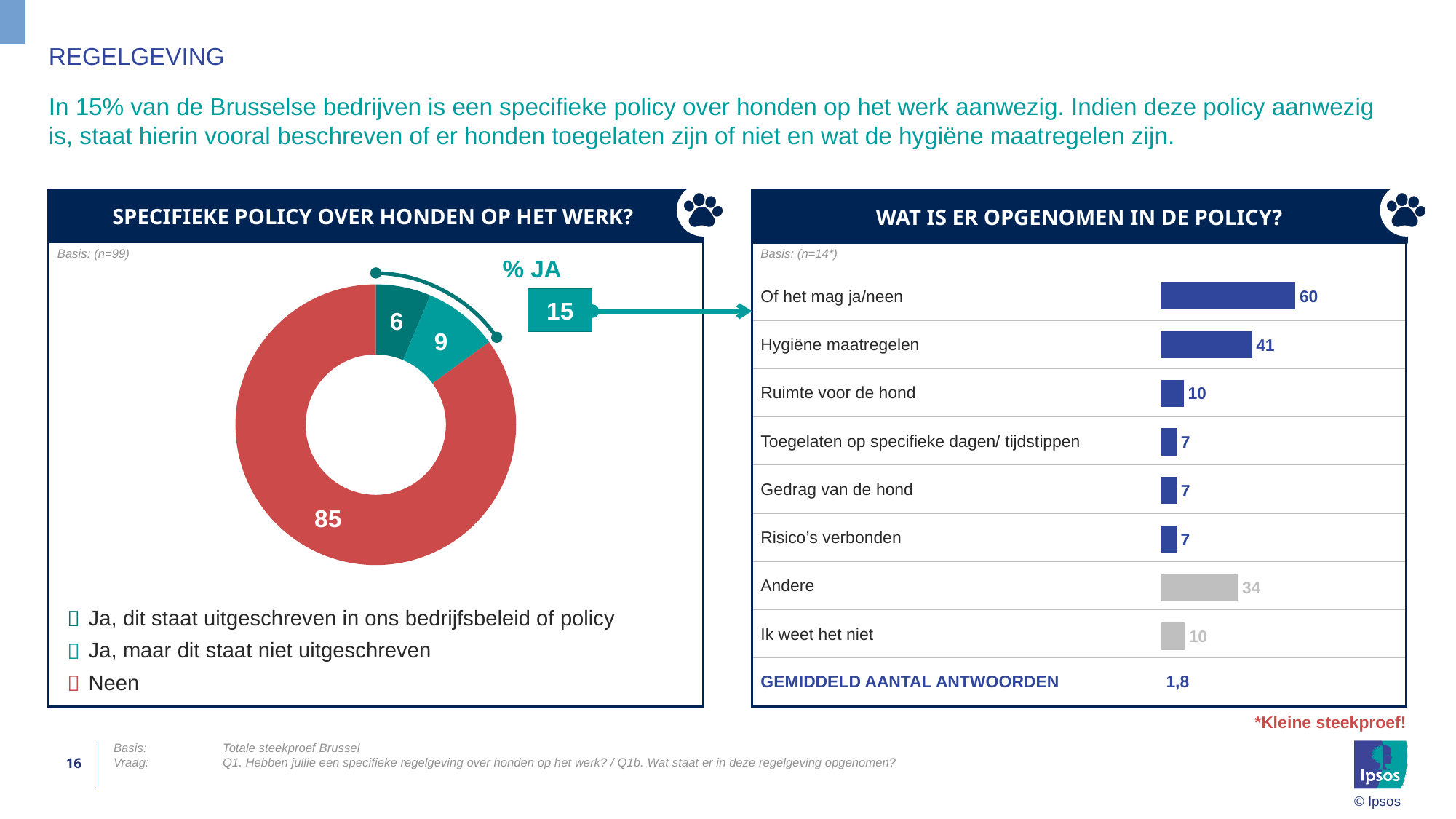
In the chart 'WAT IS ER OPGENOMEN IN DE POLICY?', which is larger: 'Andere' or 'Ruimte voor de hond'? Andere What kind of chart is 'WAT IS ER OPGENOMEN IN DE POLICY?'? Bar chart In the chart 'SPECIFIEKE POLICY OVER HONDEN OP HET WERK?', what is the value for 'Ja, dit staat uitgeschreven in ons bedrijfsbeleid of policy'? 6 How many categories are shown in the chart 'WAT IS ER OPGENOMEN IN DE POLICY?'? 8 In the chart 'SPECIFIEKE POLICY OVER HONDEN OP HET WERK?', what is the value for 'Ja, maar dit staat niet uitgeschreven'? 9 In the chart 'SPECIFIEKE POLICY OVER HONDEN OP HET WERK?', what is the combined '% JA' value shown? 15 In the chart 'WAT IS ER OPGENOMEN IN DE POLICY?', what is the difference between 'Of het mag ja/neen' and 'Hygiëne maatregelen'? 19 In the chart 'SPECIFIEKE POLICY OVER HONDEN OP HET WERK?', what is the value for 'Neen'? 85 In the chart 'WAT IS ER OPGENOMEN IN DE POLICY?', what is the value for 'Hygiëne maatregelen'? 41 In the chart 'WAT IS ER OPGENOMEN IN DE POLICY?', what is the 'GEMIDDELD AANTAL ANTWOORDEN'? 1,8 In the chart 'WAT IS ER OPGENOMEN IN DE POLICY?', which category has the highest value? Of het mag ja/neen What kind of chart is 'SPECIFIEKE POLICY OVER HONDEN OP HET WERK?'? Donut (pie) chart